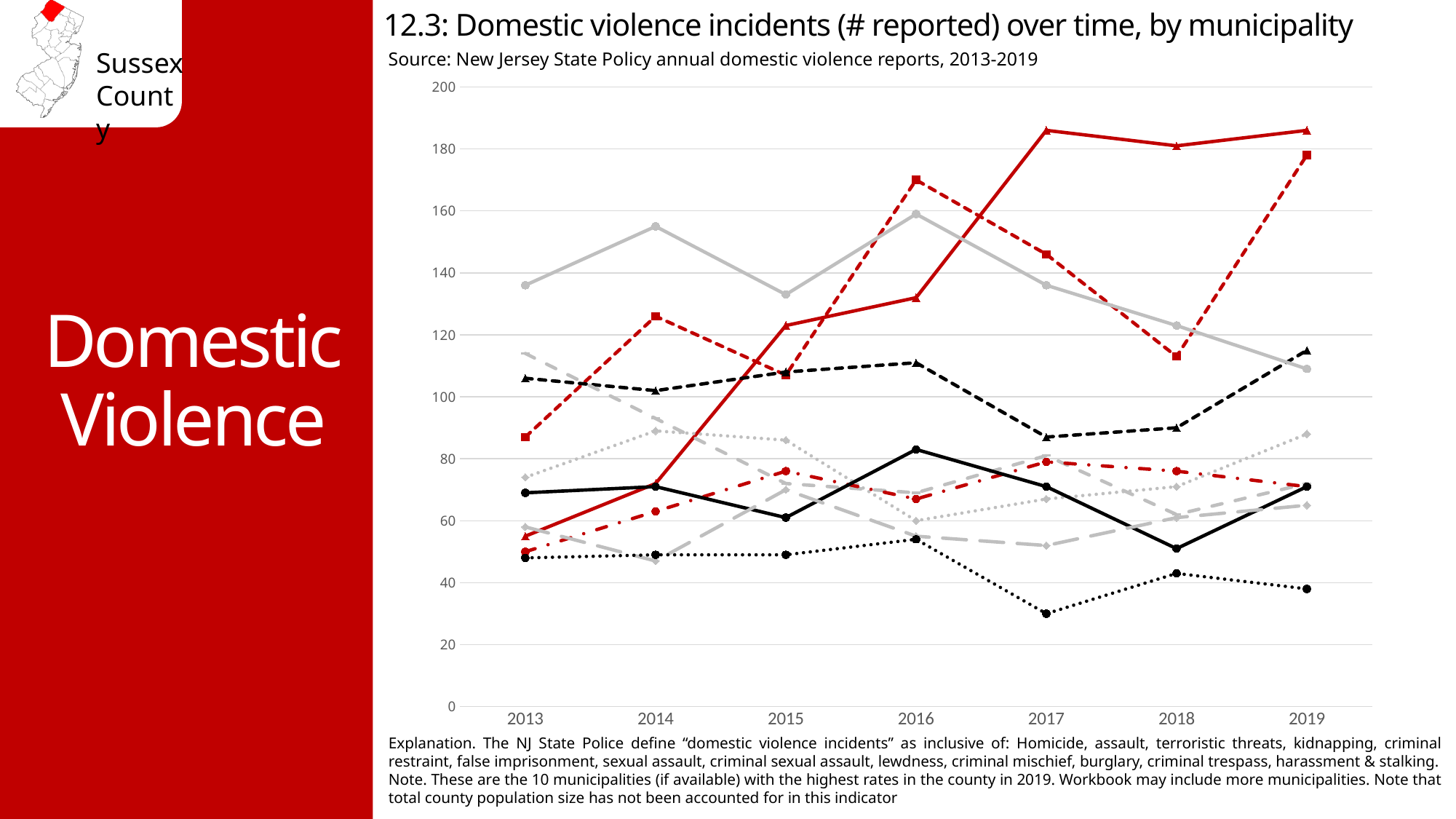
How many years are shown along the x axis of the chart? 7 What is the highest value shown on the chart's y axis? 200 Does the solid red line rise or fall between 2013 and 2017? rise Is the value of the solid red line in 2013 greater or less than 60? less Is the value of the dotted black line in 2017 greater or less than 40? less What is the title of the chart on the slide? 12.3: Domestic violence incidents (# reported) over time, by municipality Is the value of the solid grey line in 2014 greater or less than 140? greater What kind of chart is shown on the slide? line chart In 2019, which is higher: the solid red line or the solid black line? the solid red line